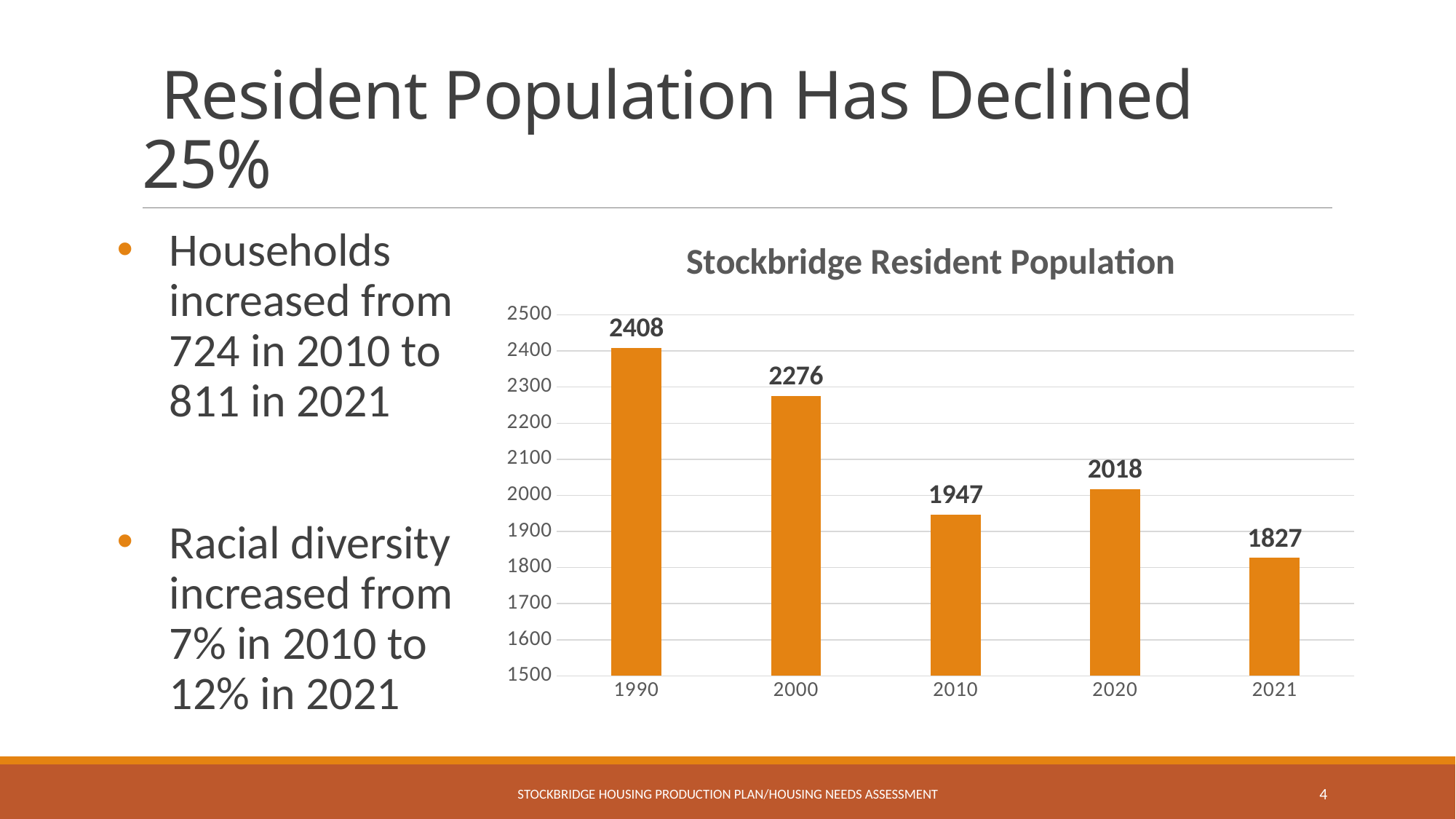
Which year has the lowest resident population in the chart? 2021 Is the resident population for 2020 greater or less than 2000? greater What is the Stockbridge resident population shown for 2010? 1947 How many years are shown on the x axis of the chart? 5 What is the difference between the resident population in 2020 and in 2010? 71 What is the title of the chart on the slide? Stockbridge Resident Population Which year has a larger resident population, 2000 or 2020? 2000 What kind of chart is used to show the Stockbridge resident population? Bar chart What is the Stockbridge resident population shown for 1990? 2408 What is the difference between the resident population in 1990 and in 2021? 581 Which year has the highest resident population in the chart? 1990 What is the Stockbridge resident population shown for 2021? 1827